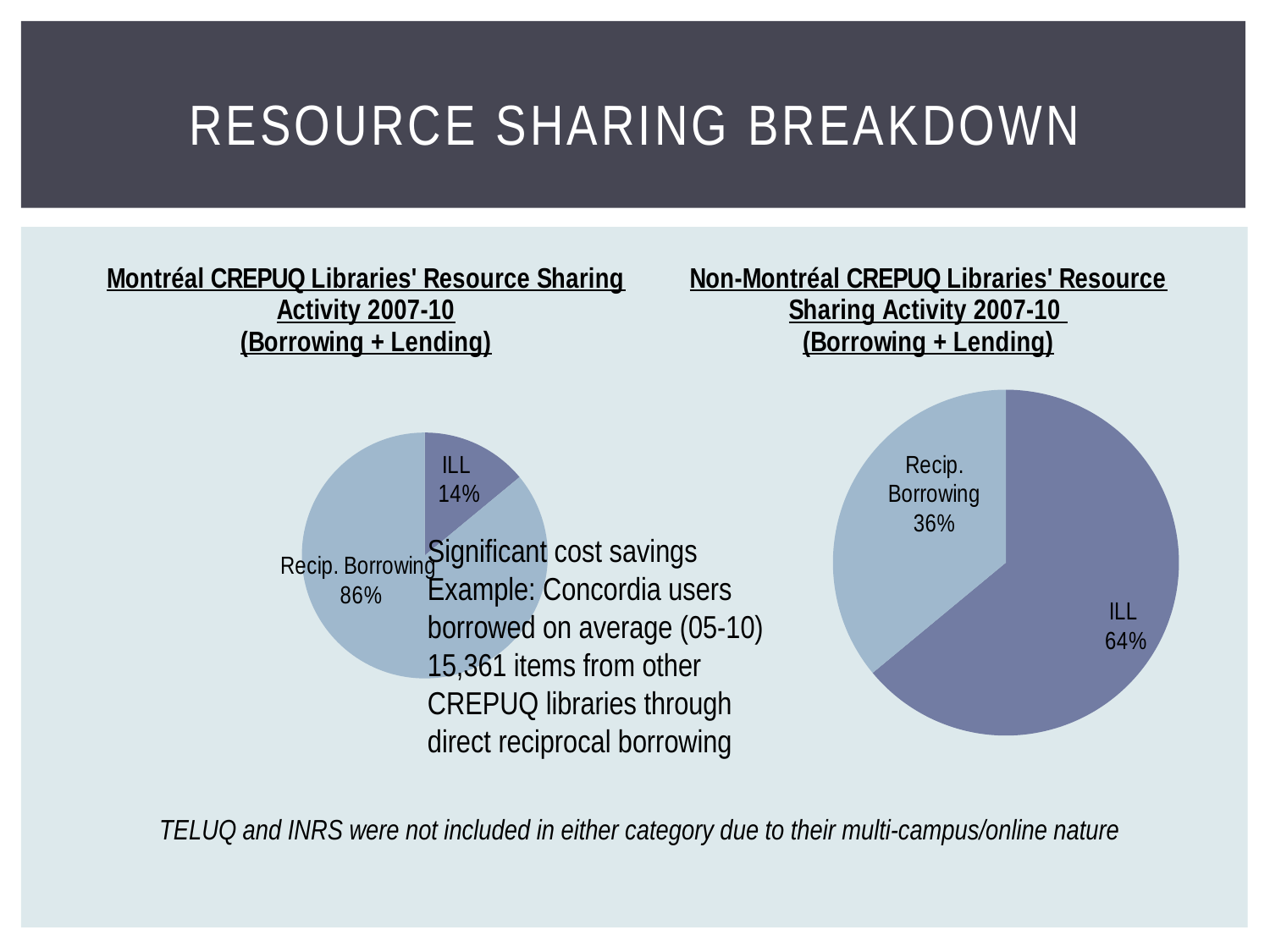
In the Montréal CREPUQ Libraries' Resource Sharing Activity 2007-10 pie chart, what share is Recip. Borrowing? 86% In the Montréal CREPUQ Libraries' Resource Sharing Activity 2007-10 pie chart, what share is ILL? 14% In the Montréal CREPUQ Libraries' pie chart, what is the difference between the Recip. Borrowing share and the ILL share? 72% In the Montréal CREPUQ Libraries' pie chart, which slice is the largest? Recip. Borrowing In the Non-Montréal CREPUQ Libraries' pie chart, which is larger: ILL or Recip. Borrowing? ILL How many slices does the Non-Montréal CREPUQ Libraries' pie chart have? 2 In the Non-Montréal CREPUQ Libraries' Resource Sharing Activity 2007-10 pie chart, what share is Recip. Borrowing? 36% In the Non-Montréal CREPUQ Libraries' Resource Sharing Activity 2007-10 pie chart, what share is ILL? 64% How many pie charts are shown on the slide? 2 What type of chart is used for the Montréal CREPUQ Libraries' Resource Sharing Activity 2007-10? Pie chart In the Non-Montréal CREPUQ Libraries' pie chart, which slice is the smallest? Recip. Borrowing What is the difference between the ILL share in the Non-Montréal chart and the ILL share in the Montréal chart? 50%